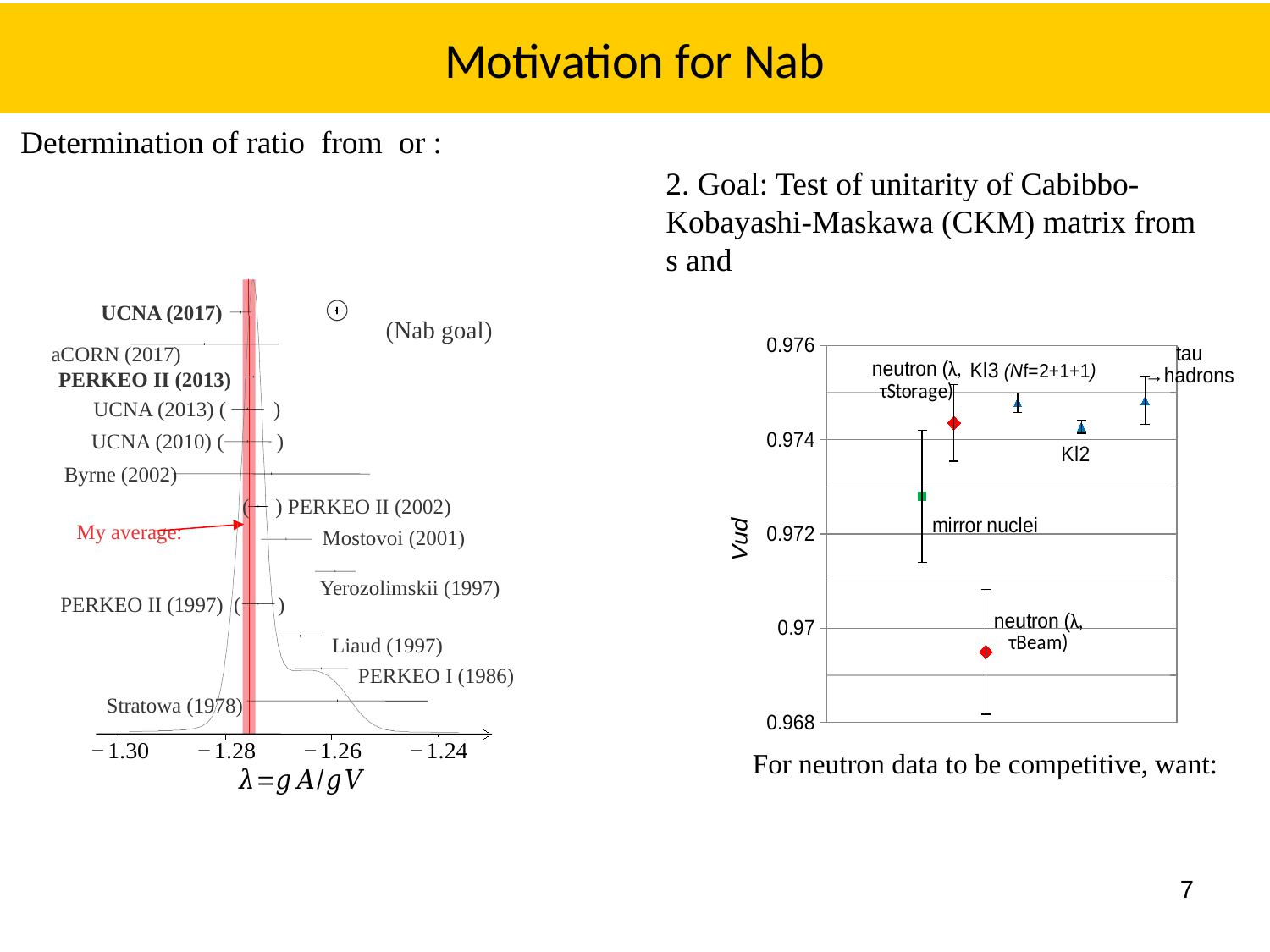
What is the x-axis label of the left chart? λ = gA/gV On the right chart (Vud), which is larger: the value for mirror nuclei or the value for neutron (λ, τBeam)? mirror nuclei On the right chart (Vud), which is larger: the value for Kl3 or the value for Kl2? Kl3 What is the y-axis label of the right chart? Vud How many experimental measurements (excluding the Nab goal) are listed on the left chart? 13 How many data points are plotted on the right chart (Vud)? 6 On the right chart (Vud), which data point has the lowest value? neutron (λ, τBeam) On the right chart (Vud), is the value for mirror nuclei greater or less than 0.972? greater On the right chart (Vud), is the value for neutron (λ, τStorage) greater or less than 0.974? greater What kind of chart is the right chart (Vud)? scatter plot with error bars On the right chart (Vud), is the value for Kl3 greater or less than 0.974? greater